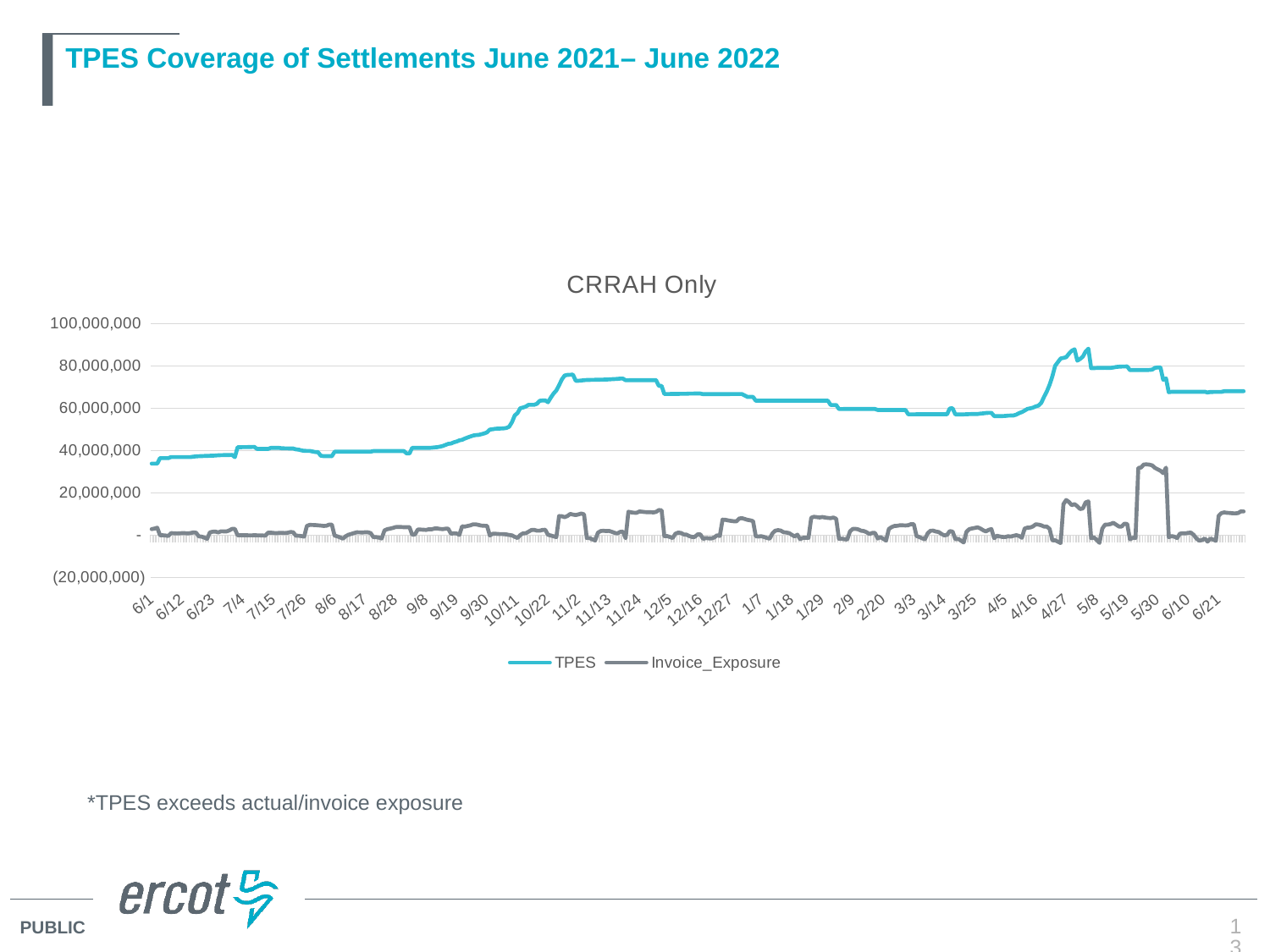
Is the TPES value at 6/1 greater or less than 40,000,000? less Is the Invoice_Exposure value at 6/1 greater or less than 20,000,000? less What kind of chart is shown on the slide? line chart Does the TPES line ever exceed 100,000,000? No How many series does the legend list? 2 Does the TPES line generally rise or fall between 6/1 and 11/2? rise What is the title of the chart? CRRAH Only Which two series are listed in the legend? TPES and Invoice_Exposure Which series stays higher across the whole period, TPES or Invoice_Exposure? TPES At 11/2, which series has the larger value, TPES or Invoice_Exposure? TPES